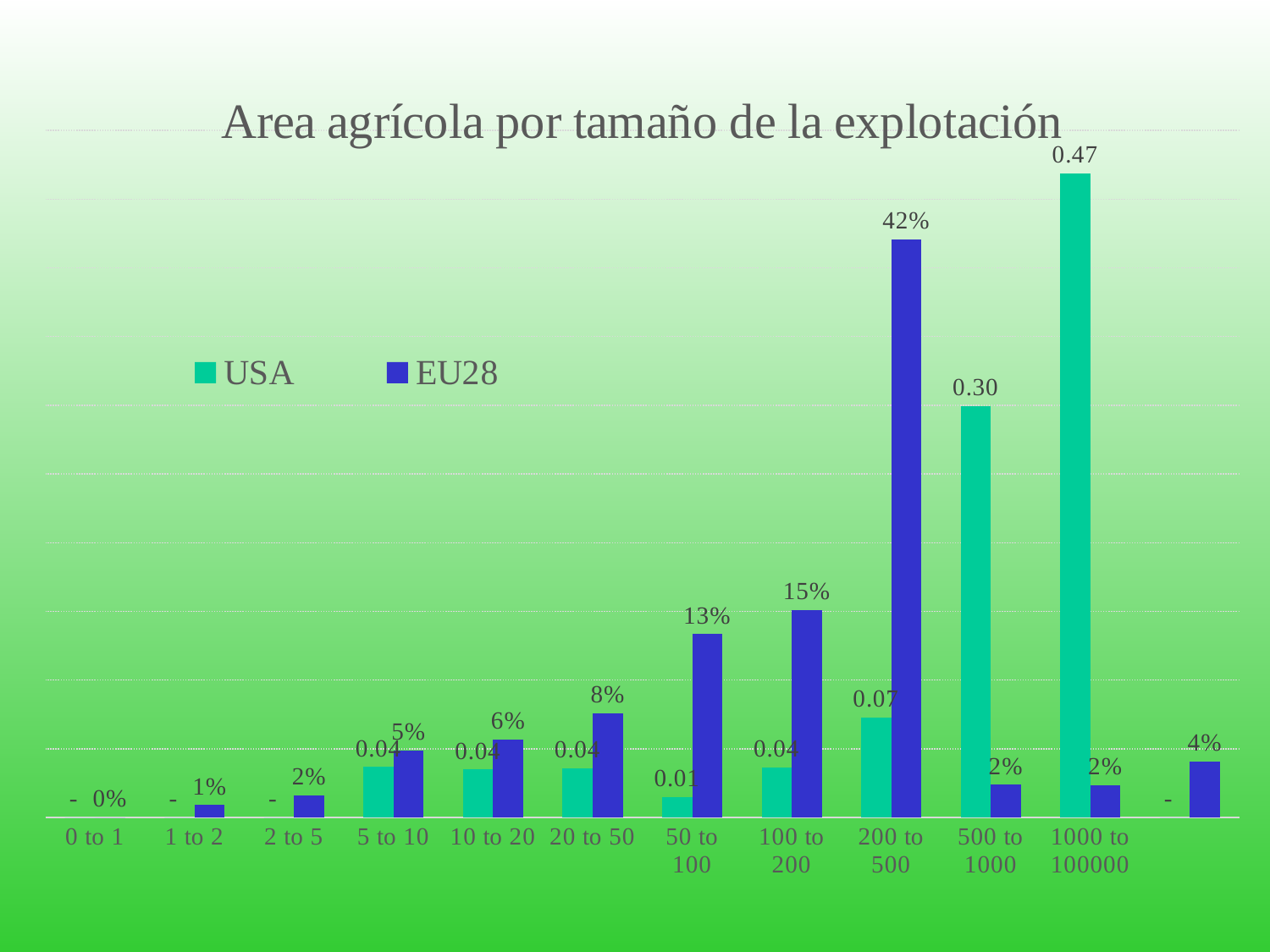
What is the USA value for the 500 to 1000 category? 0.30 What is the USA value for the 200 to 500 category? 0.07 Which category has the highest USA value? 1000 to 100000 Which category has the highest EU28 value? 200 to 500 How many series does the legend list? 2 What kind of chart is shown on the slide? bar chart In the 200 to 500 category, which series has the larger value, USA or EU28? EU28 What is the EU28 value for the 200 to 500 category? 42% What is the USA value for the 1000 to 100000 category? 0.47 What is the EU28 value for the 50 to 100 category? 13% What is the title of the chart? Area agrícola por tamaño de la explotación What is the difference between the EU28 values for 100 to 200 and 50 to 100? 2%